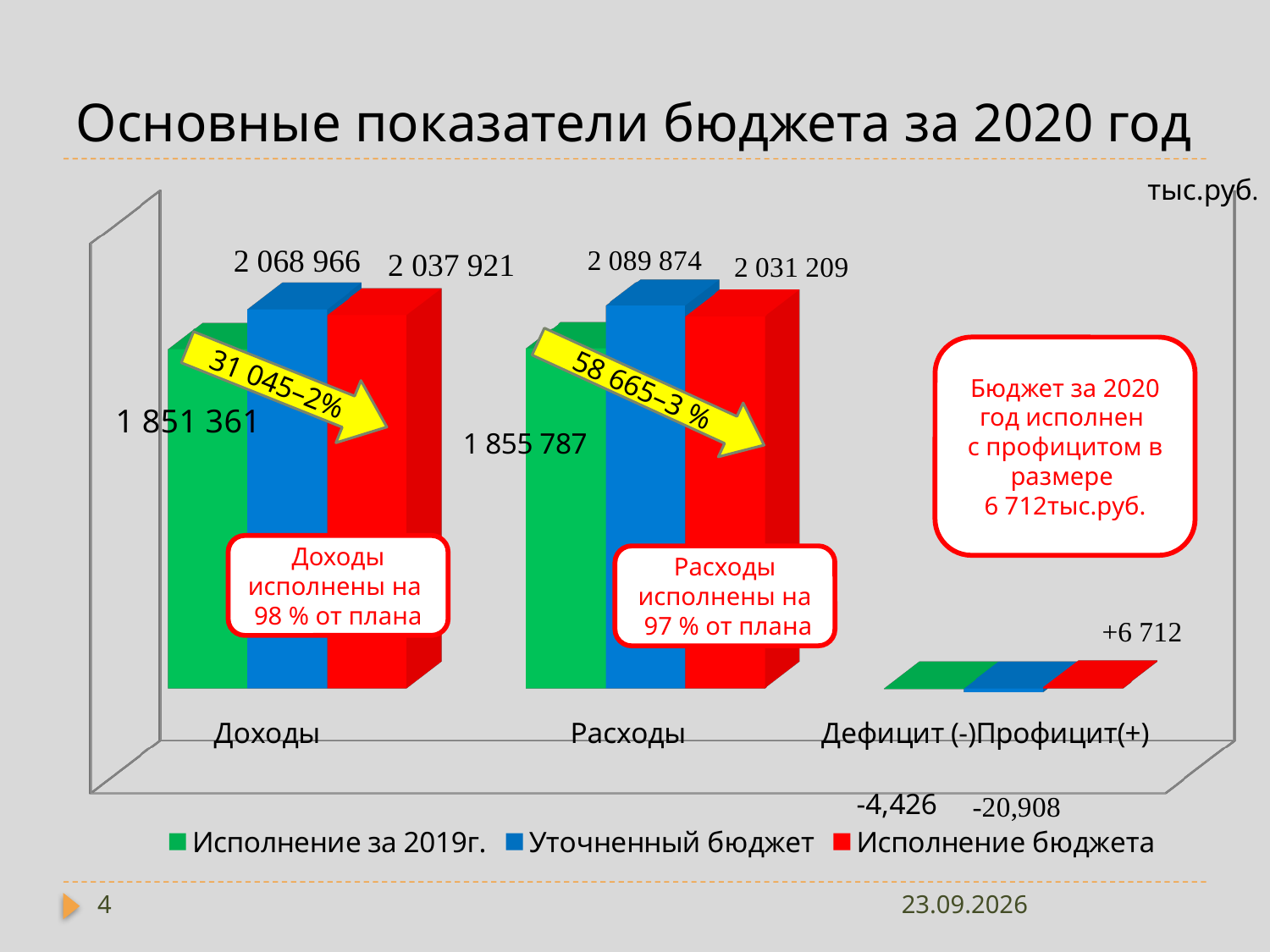
What is the value of Исполнение бюджета for Расходы? 2 031 209 How many series does the legend list? 3 Which series has the lowest value for Доходы? Исполнение за 2019г. Which series has the highest value for Расходы? Уточненный бюджет What is the value of Уточненный бюджет for Доходы? 2 068 966 What is the difference between Уточненный бюджет and Исполнение бюджета for Доходы? 31 045 Which is larger: Исполнение за 2019г. for Доходы or Исполнение за 2019г. for Расходы? Исполнение за 2019г. for Расходы What is the value of Исполнение бюджета for Дефицит (-)Профицит(+)? +6 712 What is the difference between Уточненный бюджет and Исполнение бюджета for Расходы? 58 665 What is the value of Исполнение за 2019г. for Доходы? 1 851 361 What is the value of Уточненный бюджет for Дефицит (-)Профицит(+)? -20,908 What kind of chart is shown on the slide? Bar chart